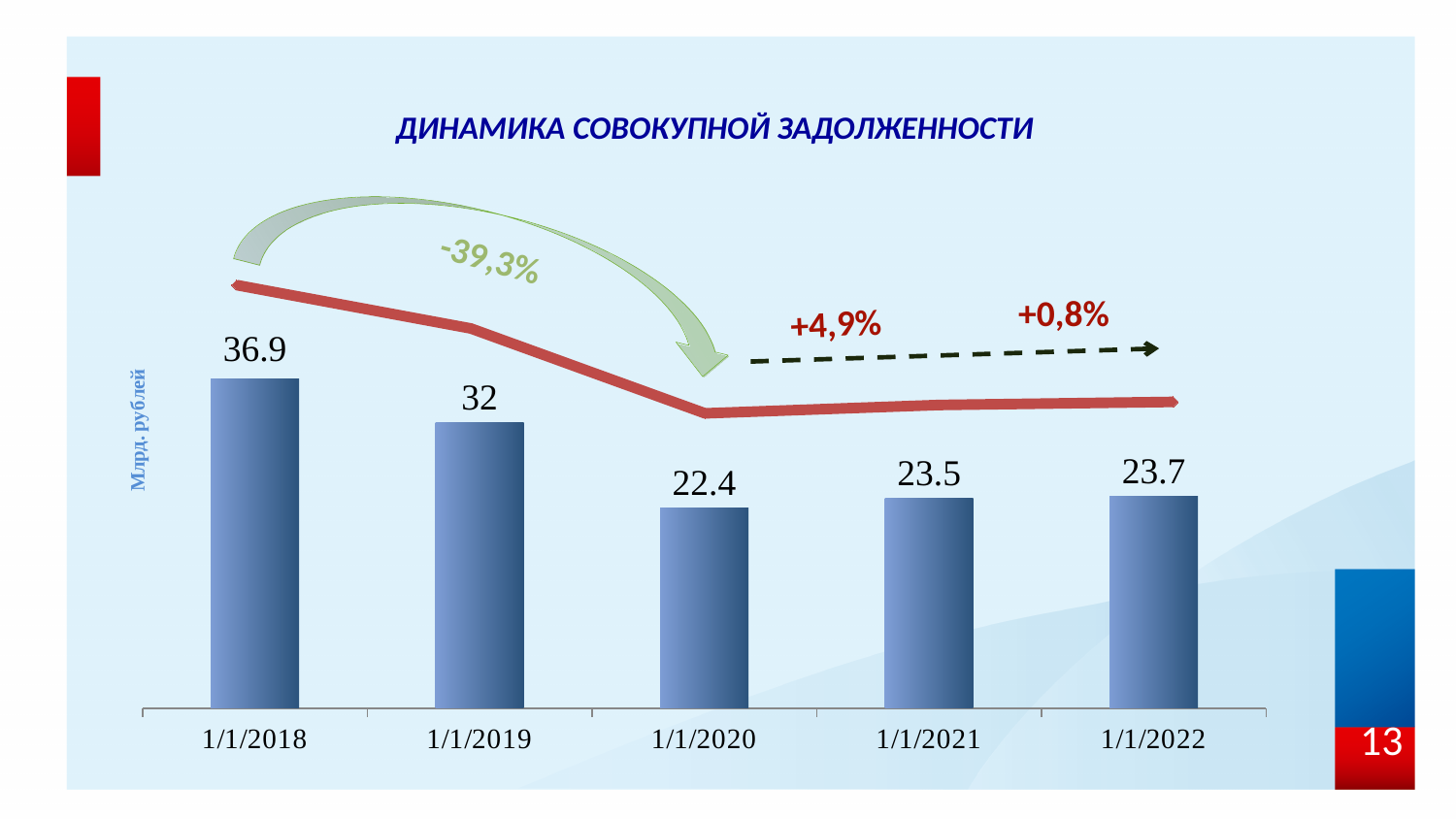
What is the difference between the values for 1/1/2018 and 1/1/2019? 4.9 What is the value for 1/1/2022? 23.7 Which date has the lowest value? 1/1/2020 Which is larger, the value for 1/1/2019 or the value for 1/1/2021? 1/1/2019 What is the value for 1/1/2018? 36.9 What kind of chart is this? bar chart What is the value for 1/1/2020? 22.4 What is the difference between the values for 1/1/2022 and 1/1/2021? 0.2 What is the title of the chart? ДИНАМИКА СОВОКУПНОЙ ЗАДОЛЖЕННОСТИ How many dates are shown on the x axis? 5 Do the values rise or fall from 1/1/2018 to 1/1/2020? fall Which date has the highest value? 1/1/2018